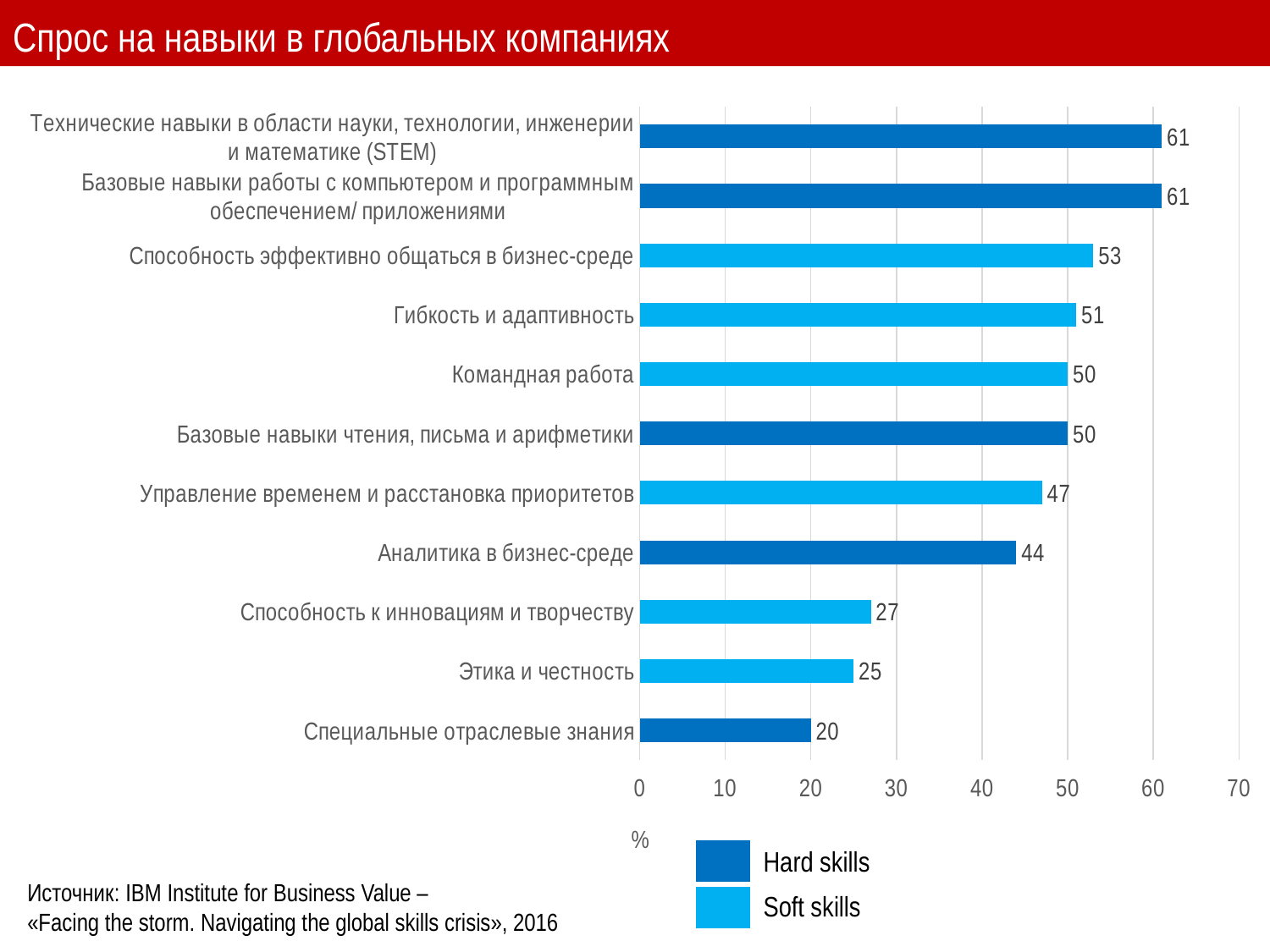
What kind of chart is shown on the slide? Bar chart How many categories are shown in the chart? 11 Which category has the lowest value? Специальные отраслевые знания What value is shown for «Аналитика в бизнес-среде»? 44 What value is shown for «Способность эффективно общаться в бизнес-среде»? 53 Which legend entry is shown in the lighter blue colour? Soft skills What is the title of the slide? Спрос на навыки в глобальных компаниях What value is shown for «Этика и честность»? 25 What value is shown for «Командная работа»? 50 What is the difference between the values for «Гибкость и адаптивность» and «Способность к инновациям и творчеству»? 24 How many series does the legend list? 2 Which is larger: the value for «Управление временем и расстановка приоритетов» or the value for «Аналитика в бизнес-среде»? Управление временем и расстановка приоритетов